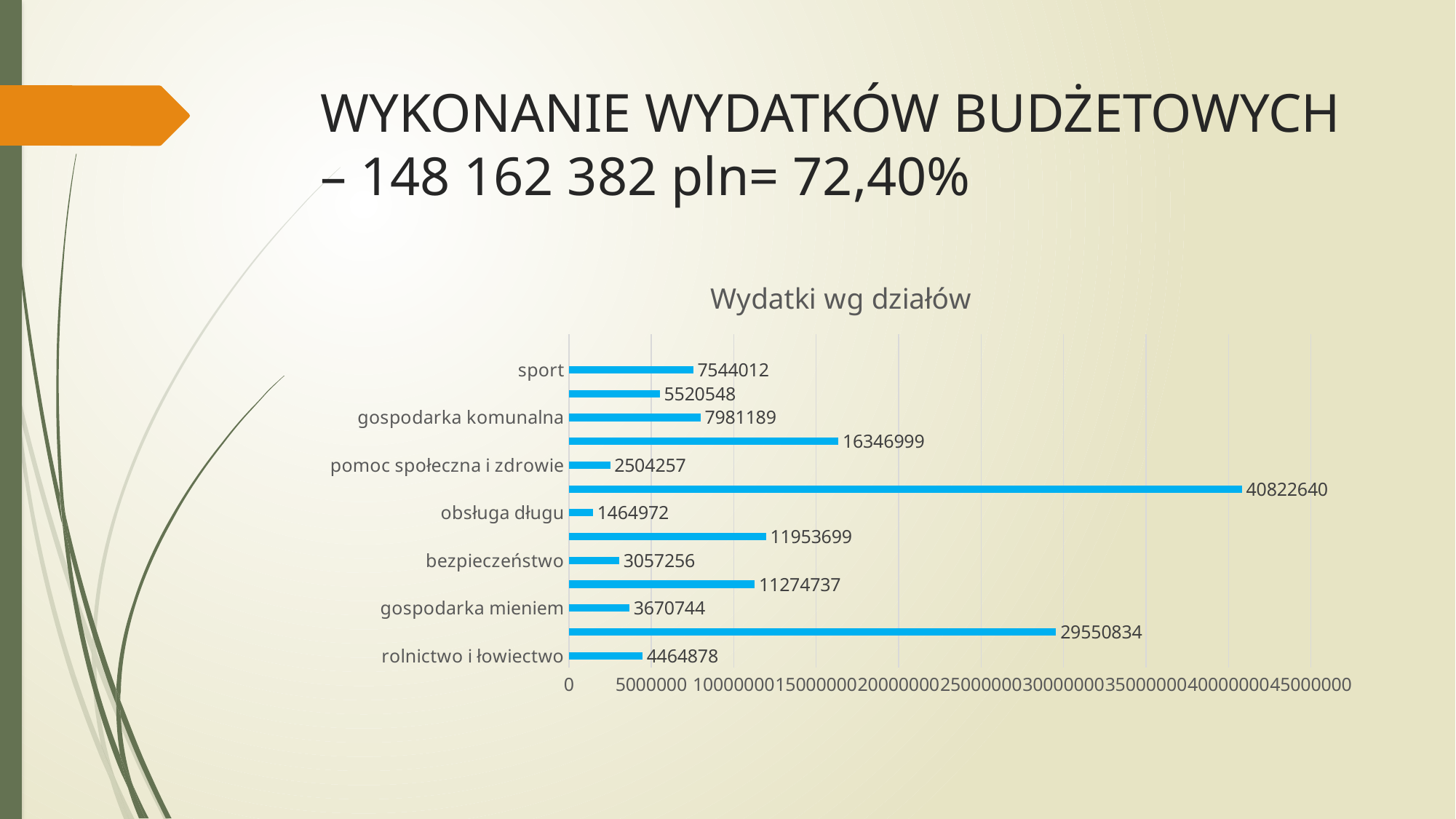
What is the difference between the values for bezpieczeństwo and pomoc społeczna i zdrowie? 552999 What is the difference between the values for sport and gospodarka mieniem? 3873268 Which labelled category has the lowest value? obsługa długu What is the largest value shown on the chart? 40822640 Which is larger, the value for gospodarka mieniem or the value for bezpieczeństwo? gospodarka mieniem What type of chart is shown? bar chart What is the value for gospodarka komunalna? 7981189 What is the value for rolnictwo i łowiectwo? 4464878 Is the value for sport greater or less than 5000000? greater What is the value for obsługa długu? 1464972 What is the value for sport? 7544012 How many bars are plotted on the chart? 13